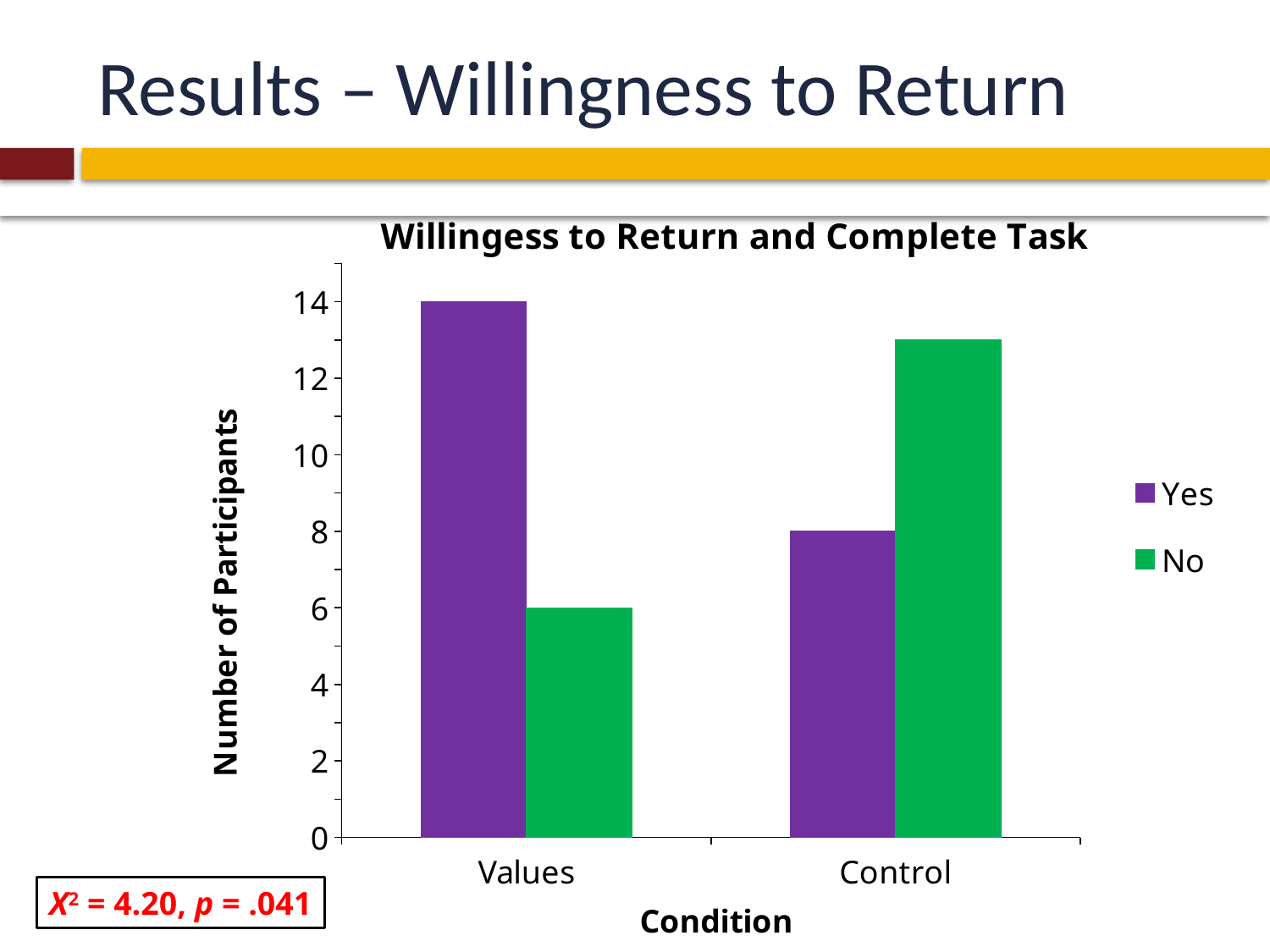
Which condition has more participants who answered Yes, Values or Control? Values Is the number of participants who answered No in the Control condition greater or less than 12? greater What is the difference between the Yes and No counts in the Values condition? 8 What is the number of participants who answered No in the Values condition? 6 Which bar in the chart is the lowest? No in the Values condition What type of chart is shown on the slide? Bar chart How many conditions are shown on the x axis? 2 What is the number of participants who answered Yes in the Values condition? 14 What is the number of participants who answered Yes in the Control condition? 8 How many series does the legend list? 2 What is the label of the y axis? Number of Participants What is the title of the chart? Willingess to Return and Complete Task